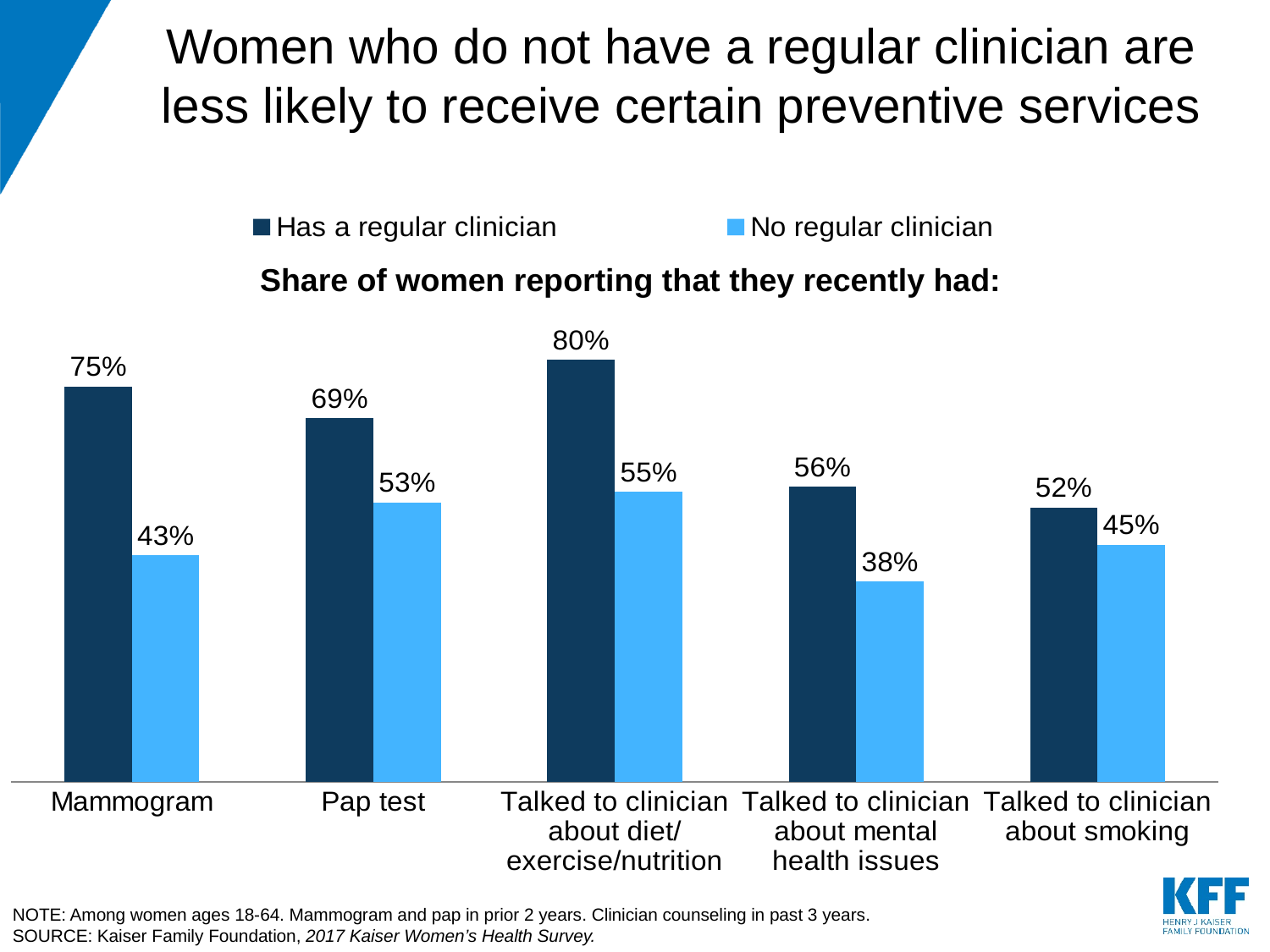
Which series is shown in light blue? No regular clinician Which is larger: the share of women with no regular clinician who had a pap test, or the share who talked to a clinician about diet/exercise/nutrition? Talked to clinician about diet/exercise/nutrition What share of women with no regular clinician reported having a pap test? 53% What kind of chart is shown on the slide? Bar chart How many series does the legend list? 2 What share of women with no regular clinician reported talking to a clinician about mental health issues? 38% What is the difference between the two groups for talking to a clinician about smoking? 7 percentage points For which service is the share among women with no regular clinician the lowest? Talked to clinician about mental health issues What is the difference between women with a regular clinician and women with no regular clinician for mammograms? 32 percentage points What share of women with a regular clinician reported having a mammogram? 75% For which service is the share among women who have a regular clinician the highest? Talked to clinician about diet/exercise/nutrition How many preventive services are shown on the x axis? 5